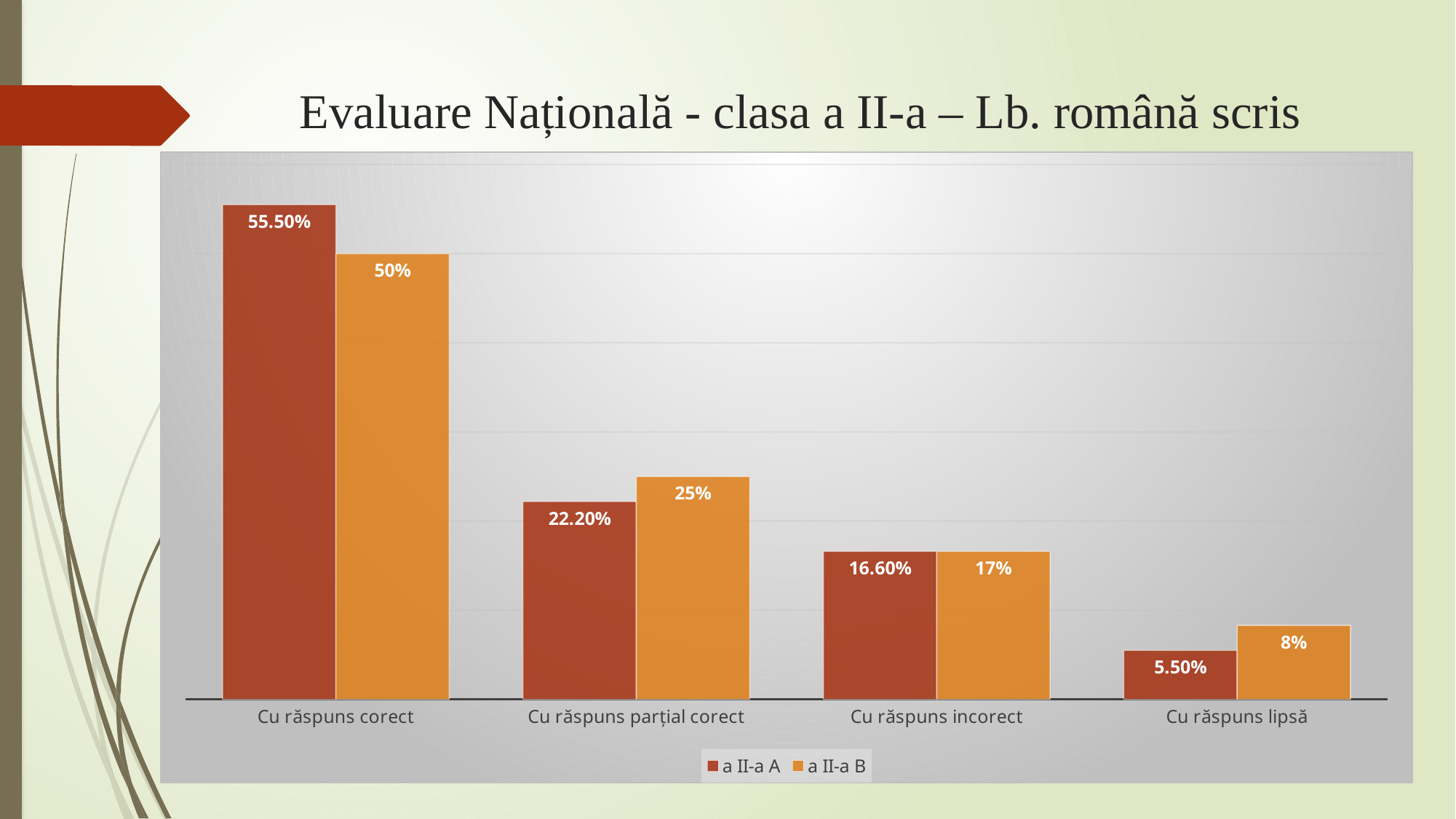
Which series has the larger value in the 'Cu răspuns parțial corect' category, 'a II-a A' or 'a II-a B'? a II-a B What kind of chart is shown on the slide? Bar chart What is the value for 'a II-a B' in the 'Cu răspuns parțial corect' category? 25% What is the value for 'a II-a A' in the 'Cu răspuns corect' category? 55.50% How many series does the legend list? 2 Which category has the lowest value for the 'a II-a B' series? Cu răspuns lipsă What is the difference between the 'a II-a A' and 'a II-a B' values in the 'Cu răspuns corect' category? 5.50% Which category has the highest value for the 'a II-a A' series? Cu răspuns corect What is the value for 'a II-a A' in the 'Cu răspuns incorect' category? 16.60% How many categories are shown on the x axis? 4 What is the value for 'a II-a B' in the 'Cu răspuns lipsă' category? 8% What is the title of the slide? Evaluare Națională - clasa a II-a – Lb. română scris